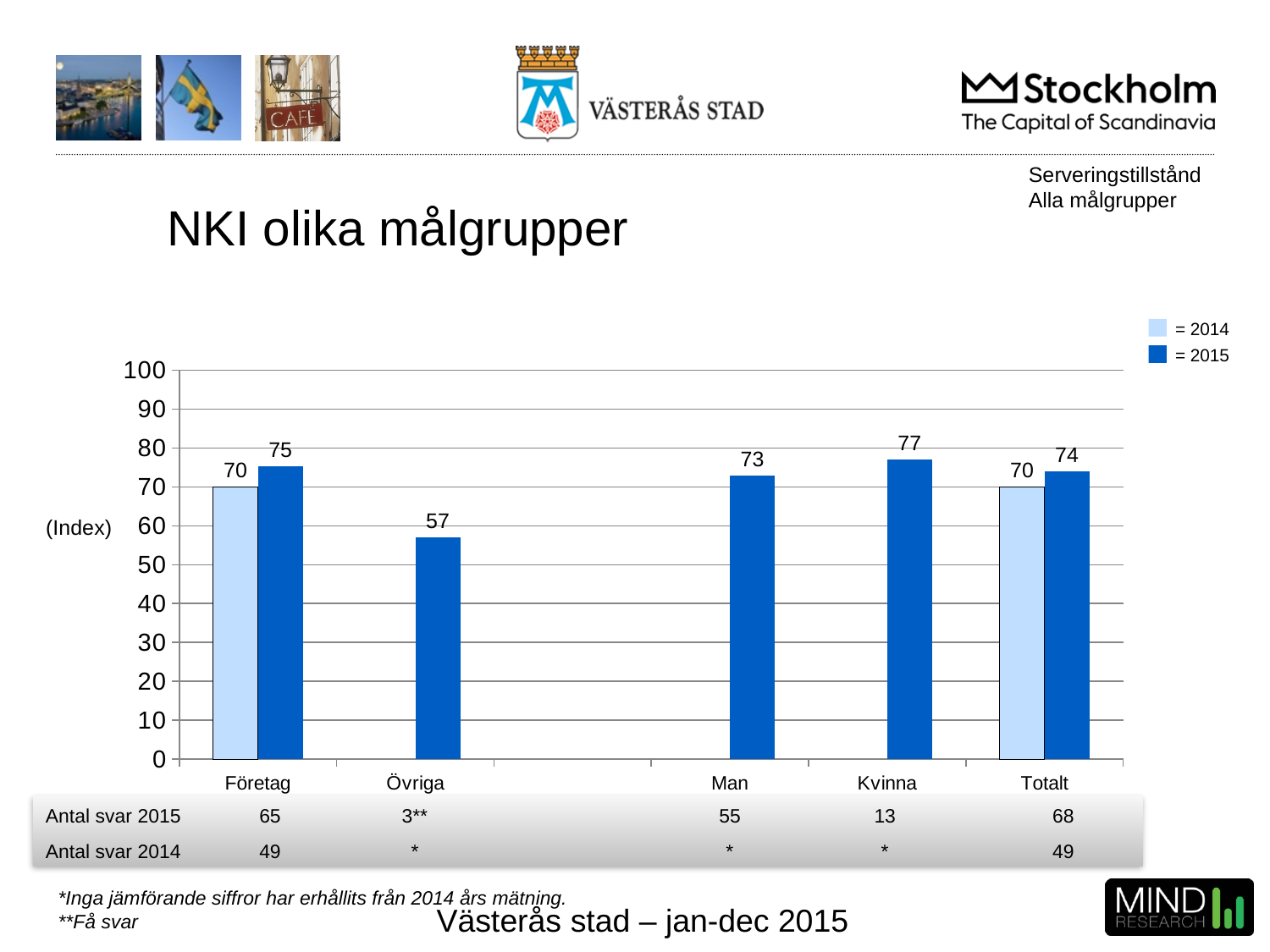
How many series does the legend list? 2 Which category has the lowest 2015 value? Övriga Which is larger, the 2015 value for Man or the 2015 value for Övriga? Man How many categories are shown on the x axis? 5 What is the 2015 value for Övriga? 57 What is the 2015 value for Företag? 75 What is the difference between the 2015 and 2014 values for Företag? 5 What is the 2014 value for Totalt? 70 What is the difference between the 2015 values for Kvinna and Man? 4 What is the 2015 value for Kvinna? 77 Which category has the highest 2015 value? Kvinna What kind of chart is shown on the slide? Bar chart